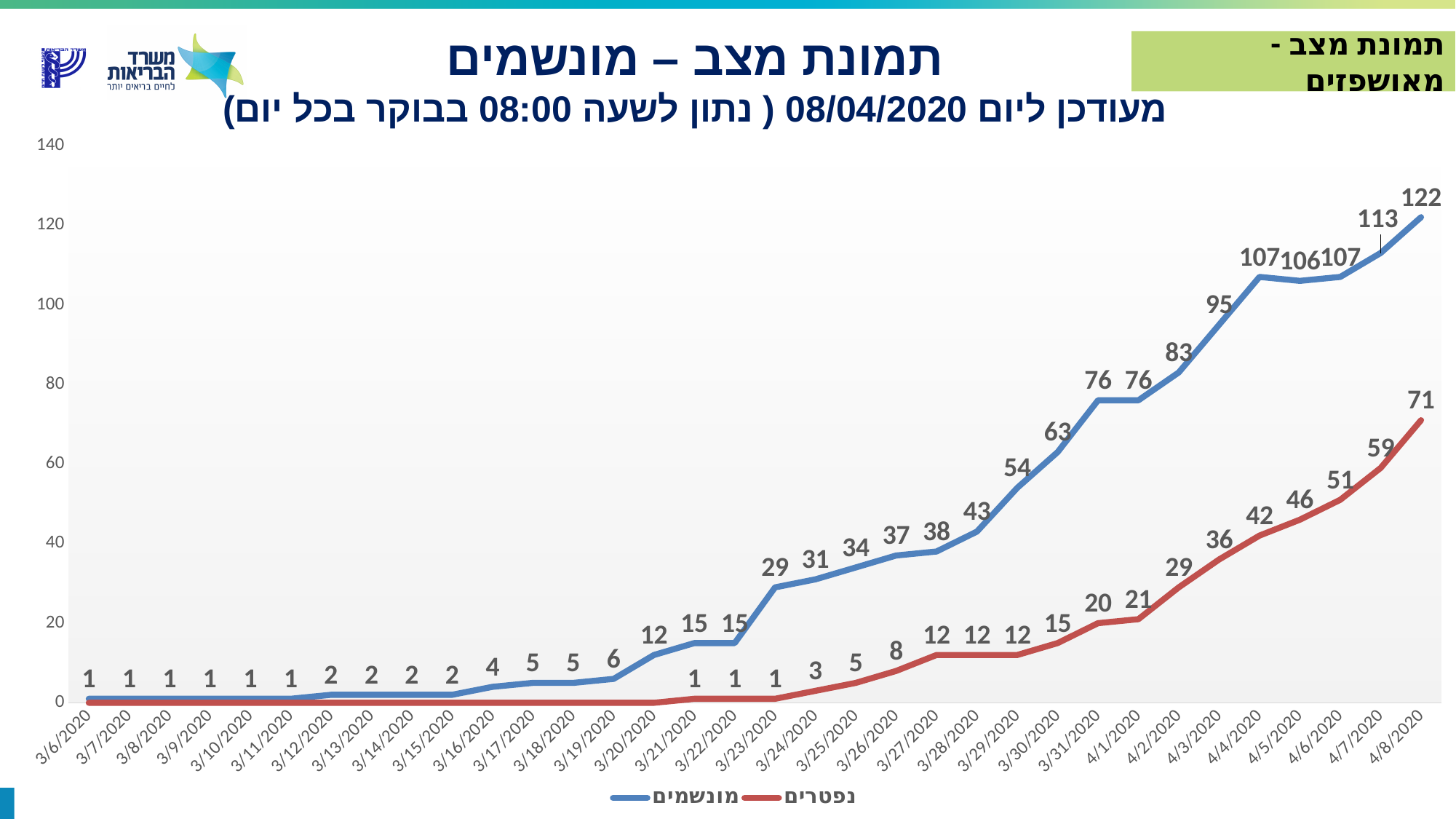
On which date does the מונשמים series reach its highest value? 4/8/2020 What is the value of the נפטרים series on 3/31/2020? 20 Does the מונשמים series generally rise or fall from 3/6/2020 to 4/8/2020? Rise What is the value of the נפטרים series on 4/8/2020? 71 What is the difference between the מונשמים value and the נפטרים value on 4/8/2020? 51 Is the value of the מונשמים series on 4/7/2020 greater or less than 100? greater What is the value of the מונשמים series on 4/8/2020? 122 What is the value of the מונשמים series on 3/23/2020? 29 How many dates are shown on the x axis? 34 How many series does the legend list? 2 Which series has the larger value on 4/4/2020, מונשמים or נפטרים? מונשמים What kind of chart is shown on the slide? Line chart